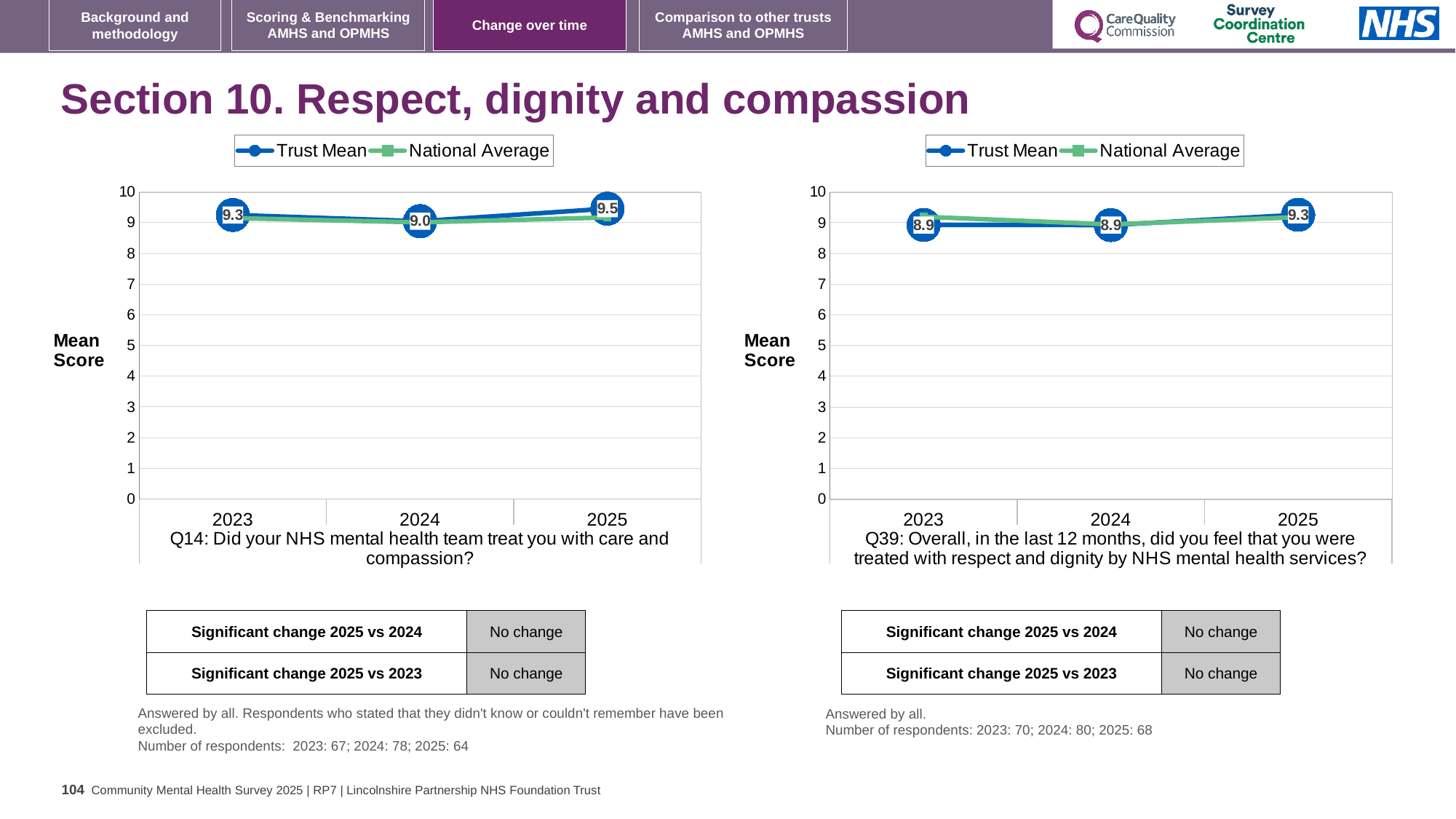
On the right chart (Q39), what is the Trust Mean for 2025? 9.3 What type of chart is the left chart (Q14)? Line chart On the left chart (Q14), which year has the highest Trust Mean? 2025 How many years are plotted on the x axis of the right chart (Q39)? 3 On the right chart (Q39), is the Trust Mean for 2025 greater or less than 9? greater How many series does the legend of the left chart (Q14) list? 2 On the left chart (Q14), what is the difference between the Trust Mean in 2025 and in 2024? 0.5 On the left chart (Q14), what is the Trust Mean for 2025? 9.5 On the right chart (Q39), what is the difference between the Trust Mean in 2025 and in 2023? 0.4 On the left chart (Q14), which year has the lowest Trust Mean? 2024 On the right chart (Q39), what is the Trust Mean for 2023? 8.9 On the left chart (Q14), what is the Trust Mean for 2024? 9.0